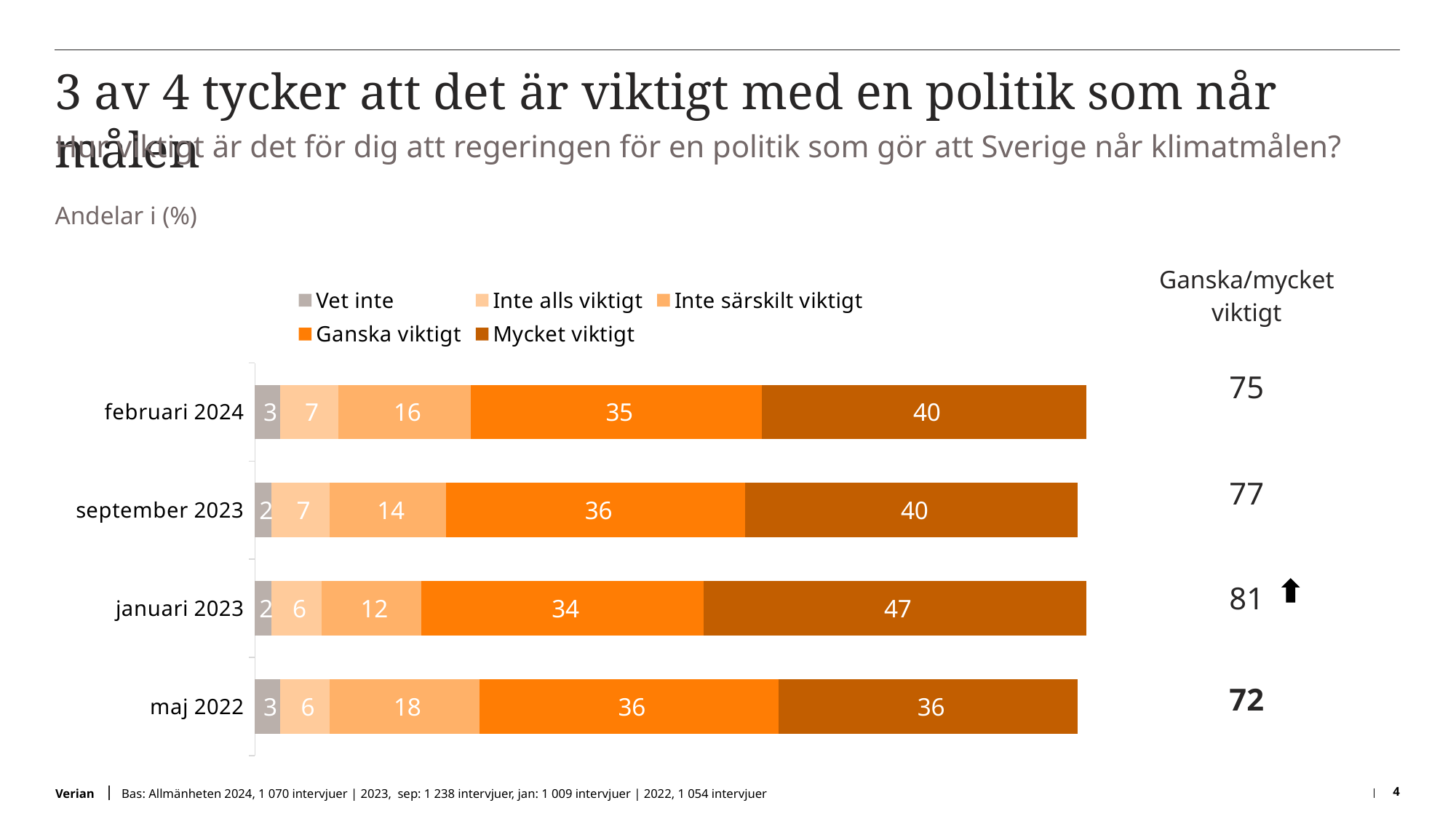
How many time periods are shown in the chart? 4 What is the value for "Vet inte" in september 2023? 2 What is the "Ganska/mycket viktigt" figure shown for januari 2023? 81 What kind of chart is shown on the slide? stacked bar chart How many series does the legend list? 5 Which period has the highest value for "Mycket viktigt"? januari 2023 What is the value for "Mycket viktigt" in januari 2023? 47 What unit does the subtitle say the values are shown in? Andelar i (%) Which is larger, the "Ganska viktigt" value for februari 2024 or for september 2023? september 2023 What is the value for "Inte särskilt viktigt" in maj 2022? 18 What is the difference between the "Mycket viktigt" values for januari 2023 and maj 2022? 11 Which period has the lowest value for "Mycket viktigt"? maj 2022